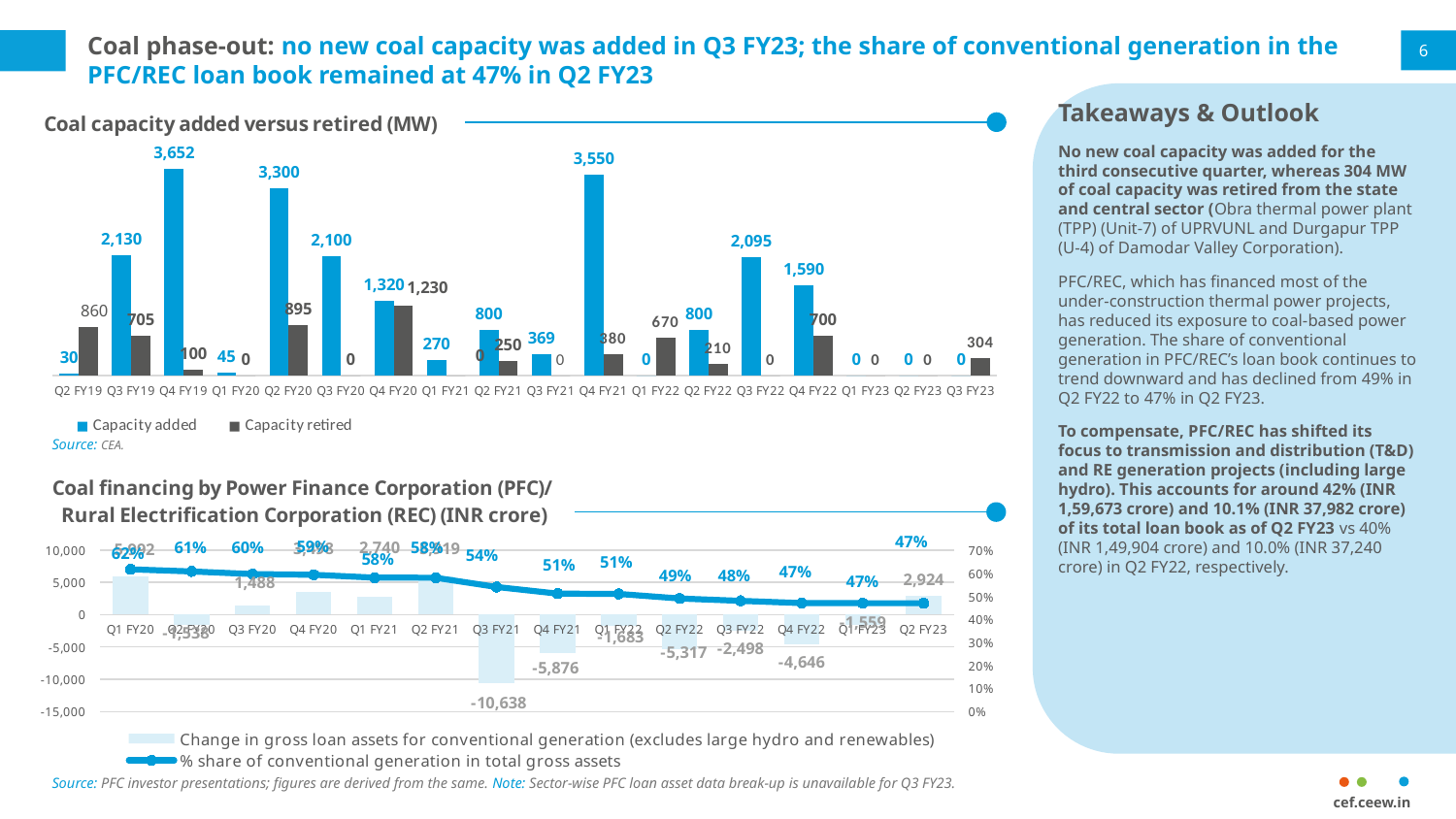
In the 'Coal capacity added versus retired (MW)' chart, which quarter has the highest capacity retired? Q4 FY20 How many series does the legend of the 'Coal capacity added versus retired (MW)' chart list? 2 In the 'Coal capacity added versus retired (MW)' chart, what was the capacity added in Q4 FY19? 3,652 In the 'Coal financing by Power Finance Corporation (PFC)/Rural Electrification Corporation (REC) (INR crore)' chart, what was the % share of conventional generation in total gross assets in Q2 FY23? 47% In the 'Coal capacity added versus retired (MW)' chart, what is the difference between capacity added and capacity retired in Q4 FY20? 90 In the 'Coal capacity added versus retired (MW)' chart, what was the capacity retired in Q3 FY23? 304 In the 'Coal capacity added versus retired (MW)' chart, which quarter has the highest capacity added? Q4 FY19 How many quarters are shown on the x axis of the 'Coal capacity added versus retired (MW)' chart? 18 In the 'Coal financing by Power Finance Corporation (PFC)/Rural Electrification Corporation (REC) (INR crore)' chart, what was the change in gross loan assets for conventional generation in Q3 FY21? -10,638 In the 'Coal financing by Power Finance Corporation (PFC)/Rural Electrification Corporation (REC) (INR crore)' chart, does the % share of conventional generation in total gross assets rise or fall from Q1 FY20 to Q2 FY23? Fall In the 'Coal financing by Power Finance Corporation (PFC)/Rural Electrification Corporation (REC) (INR crore)' chart, which quarter has the lowest change in gross loan assets for conventional generation? Q3 FY21 In the 'Coal capacity added versus retired (MW)' chart, which is larger in Q2 FY19: capacity added or capacity retired? Capacity retired